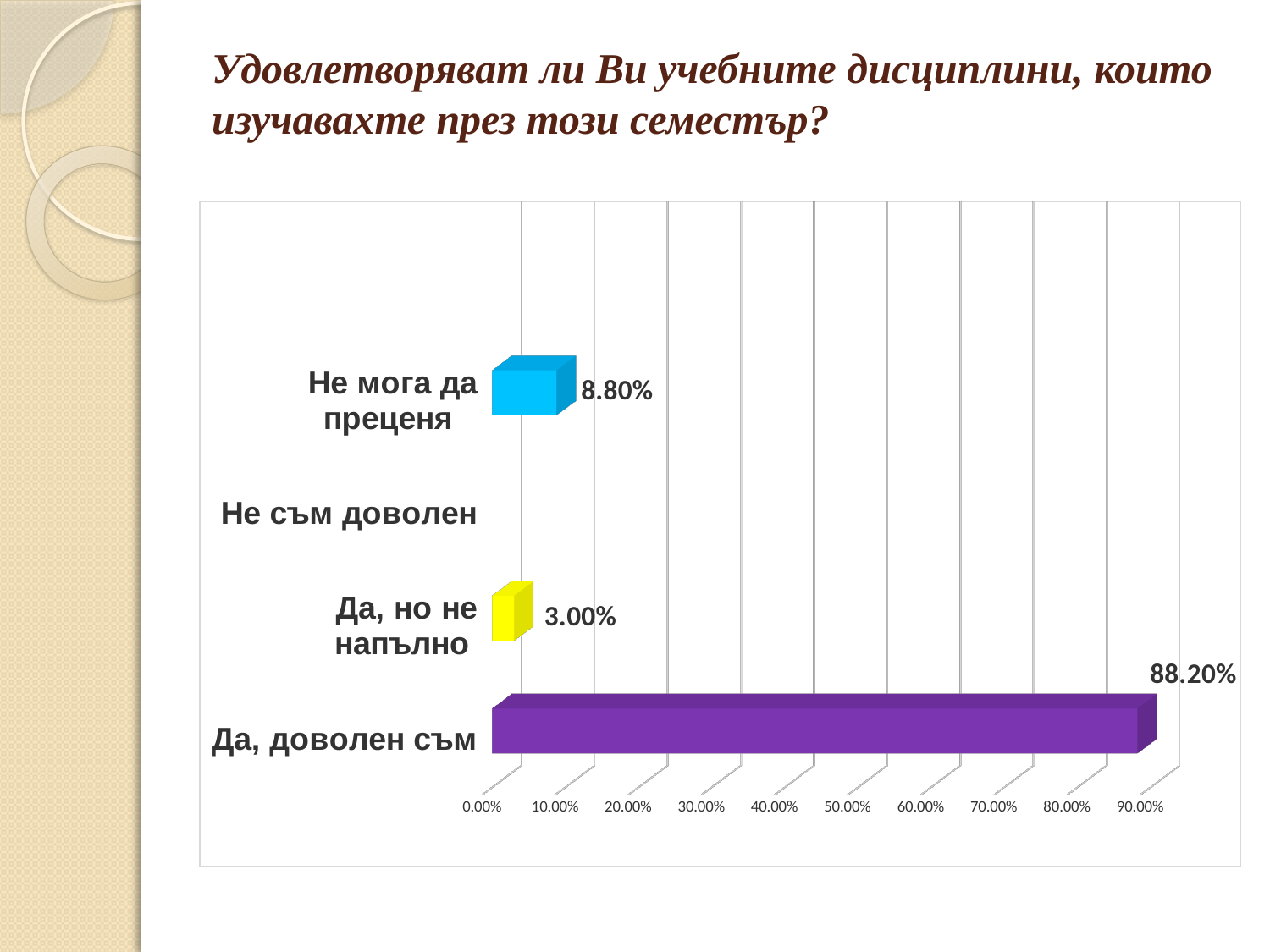
Is the value for "Не мога да преценя" greater or less than 10.00%? less Is the value for "Да, доволен съм" greater or less than 80.00%? greater What is the difference between the values for "Да, доволен съм" and "Не мога да преценя"? 79.40% Which is larger, the value for "Не мога да преценя" or the value for "Да, но не напълно"? Не мога да преценя What percentage of respondents answered "Да, доволен съм"? 88.20% What is the value shown for "Да, но не напълно"? 3.00% How many categories are shown on the chart's vertical axis? 4 Which category has the highest value in the chart? Да, доволен съм What is the value shown for "Не мога да преценя"? 8.80% What type of chart is shown on the slide? Bar chart What colour is the bar for "Да, доволен съм"? Purple What is the difference between the values for "Не мога да преценя" and "Да, но не напълно"? 5.80%